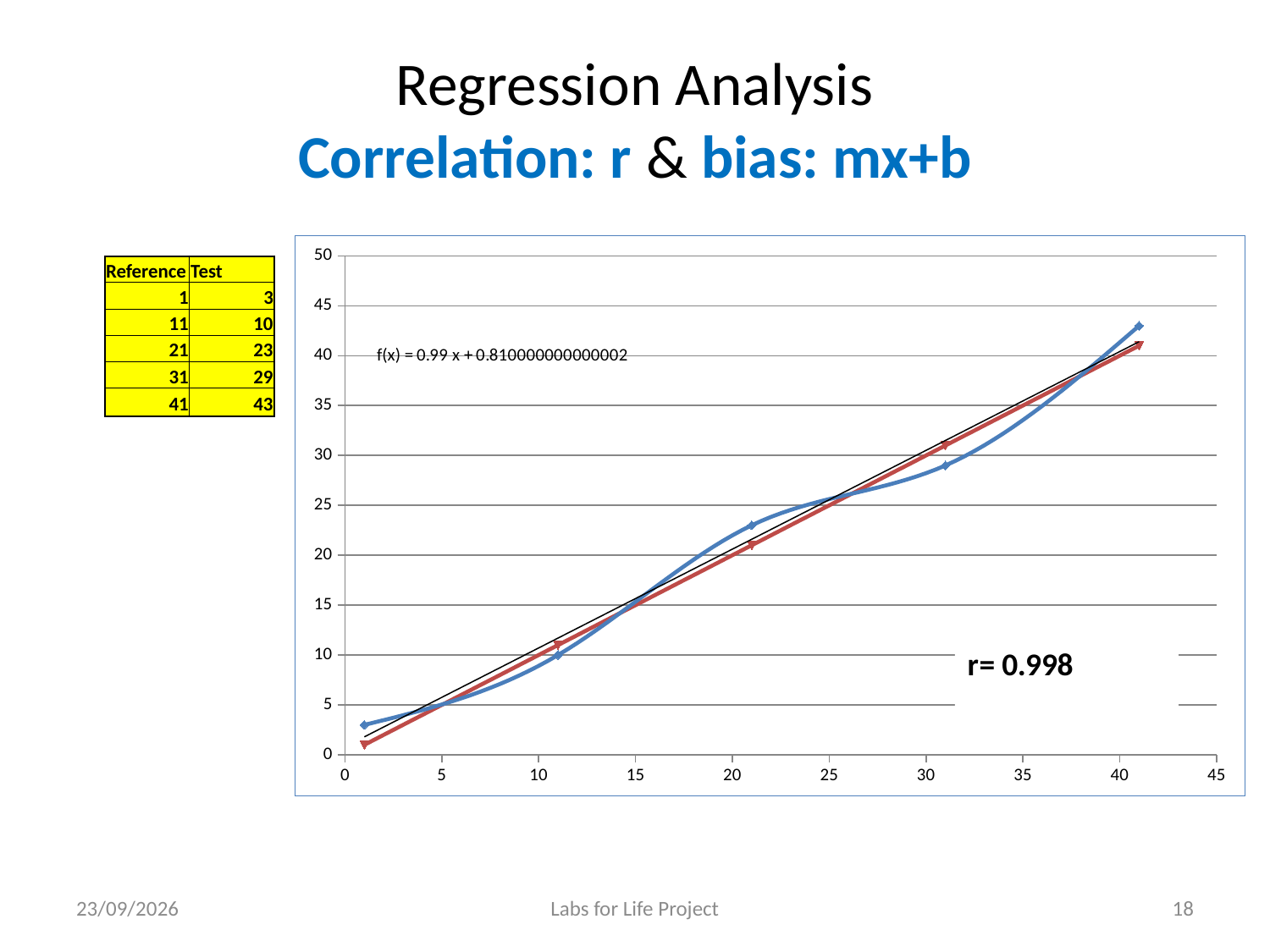
How many data points are plotted for the Test series? 5 What is the highest Test value plotted on the chart? 43 What is the Test value plotted at Reference 31? 29 At Reference 11, which is larger: the Test value or the Reference value? Reference What is the Test value plotted at Reference 41? 43 What is the difference between the Test value at Reference 41 and the Test value at Reference 31? 14 Do the Test values rise or fall as the Reference value increases along the x axis? rise What kind of chart is shown on the slide? scatter chart with smoothed lines What correlation coefficient r is shown on the chart? 0.998 Is the Test value plotted at Reference 21 greater or less than 20? greater What is the lowest Test value plotted on the chart? 3 What is the slope in the trendline equation f(x) shown on the chart? 0.99